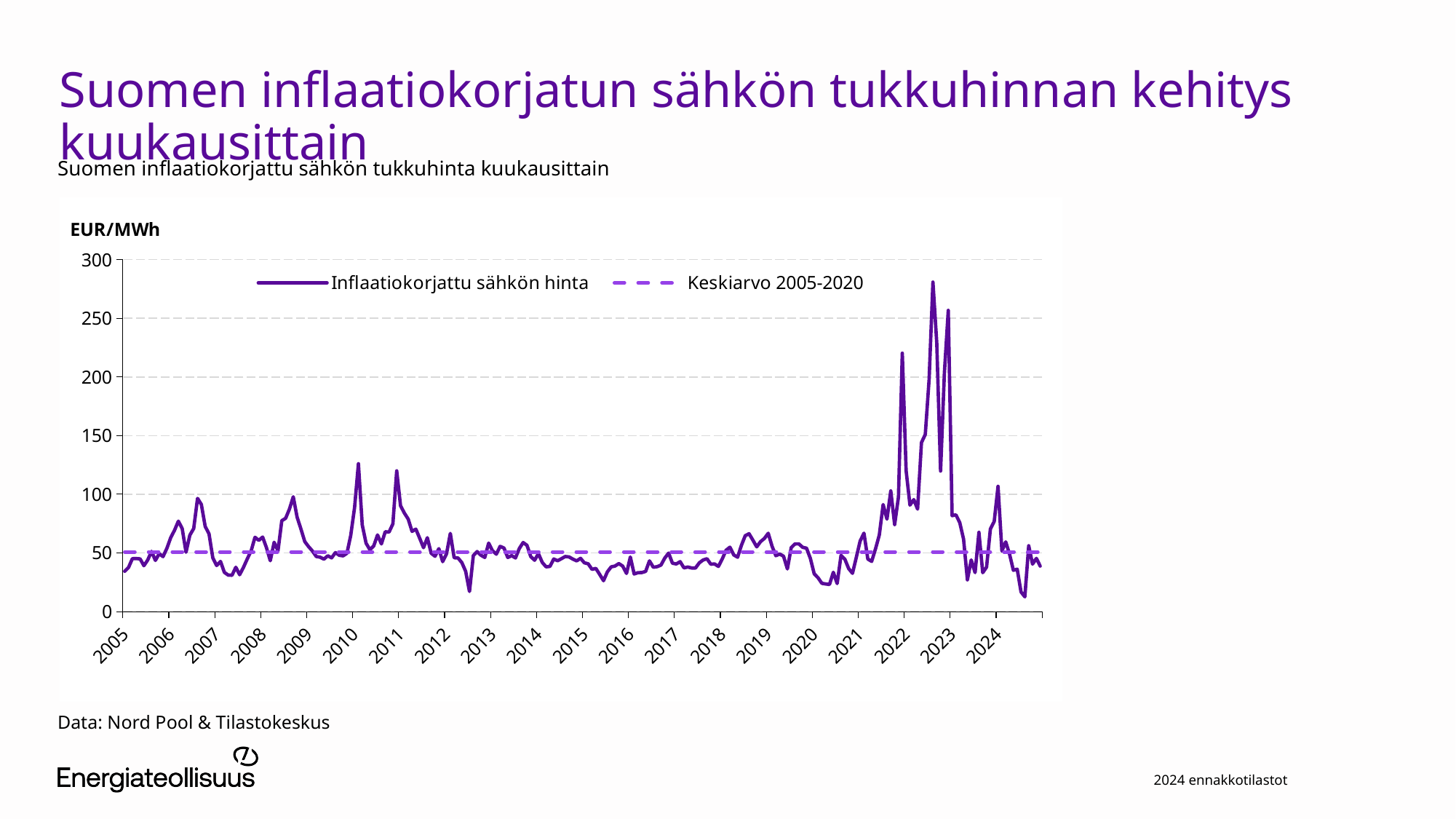
What are the two entries in the chart legend? Inflaatiokorjattu sähkön hinta; Keskiarvo 2005-2020 Is the price at the start of 2005 greater or less than 50 EUR/MWh? less Is the peak of the price line in 2010 greater or less than 100 EUR/MWh? greater In which year does the inflation-adjusted electricity price reach its highest peak? 2022 How many series does the chart legend list? 2 What kind of chart is shown on the slide? line chart From the peak in 2022 to 2024, does the inflation-adjusted price rise or fall? fall How many year labels are shown on the x axis? 20 Is the highest peak of the price line in 2022 greater or less than 250 EUR/MWh? greater Which is higher: the peak of the price line in 2022 or the peak in 2010? 2022 What unit is shown on the y axis of the chart? EUR/MWh